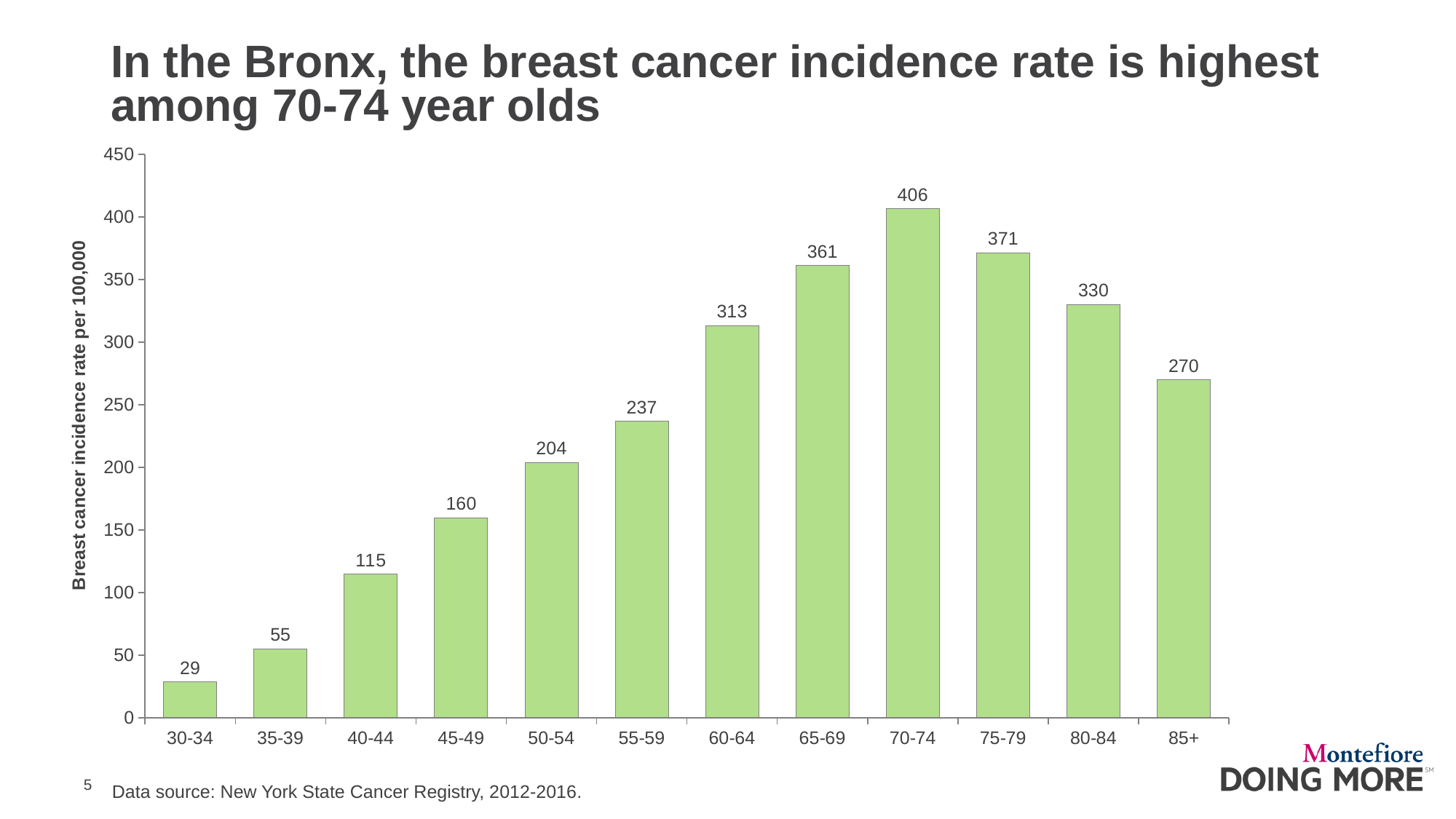
What is the breast cancer incidence rate per 100,000 for the 85+ age group? 270 What kind of chart is shown on the slide? Bar chart What is the difference in incidence rate between the 60-64 and 50-54 age groups? 109 Which age group has the lowest breast cancer incidence rate? 30-34 What is the breast cancer incidence rate per 100,000 for the 70-74 age group? 406 What is the difference in incidence rate between the 70-74 and 75-79 age groups? 35 How many age groups are shown on the chart? 12 Which age group has a higher incidence rate, 65-69 or 80-84? 65-69 Is the incidence rate for the 55-59 age group greater or less than 250? less What is the breast cancer incidence rate per 100,000 for the 45-49 age group? 160 Which age group has the highest breast cancer incidence rate? 70-74 What is the label of the vertical axis? Breast cancer incidence rate per 100,000